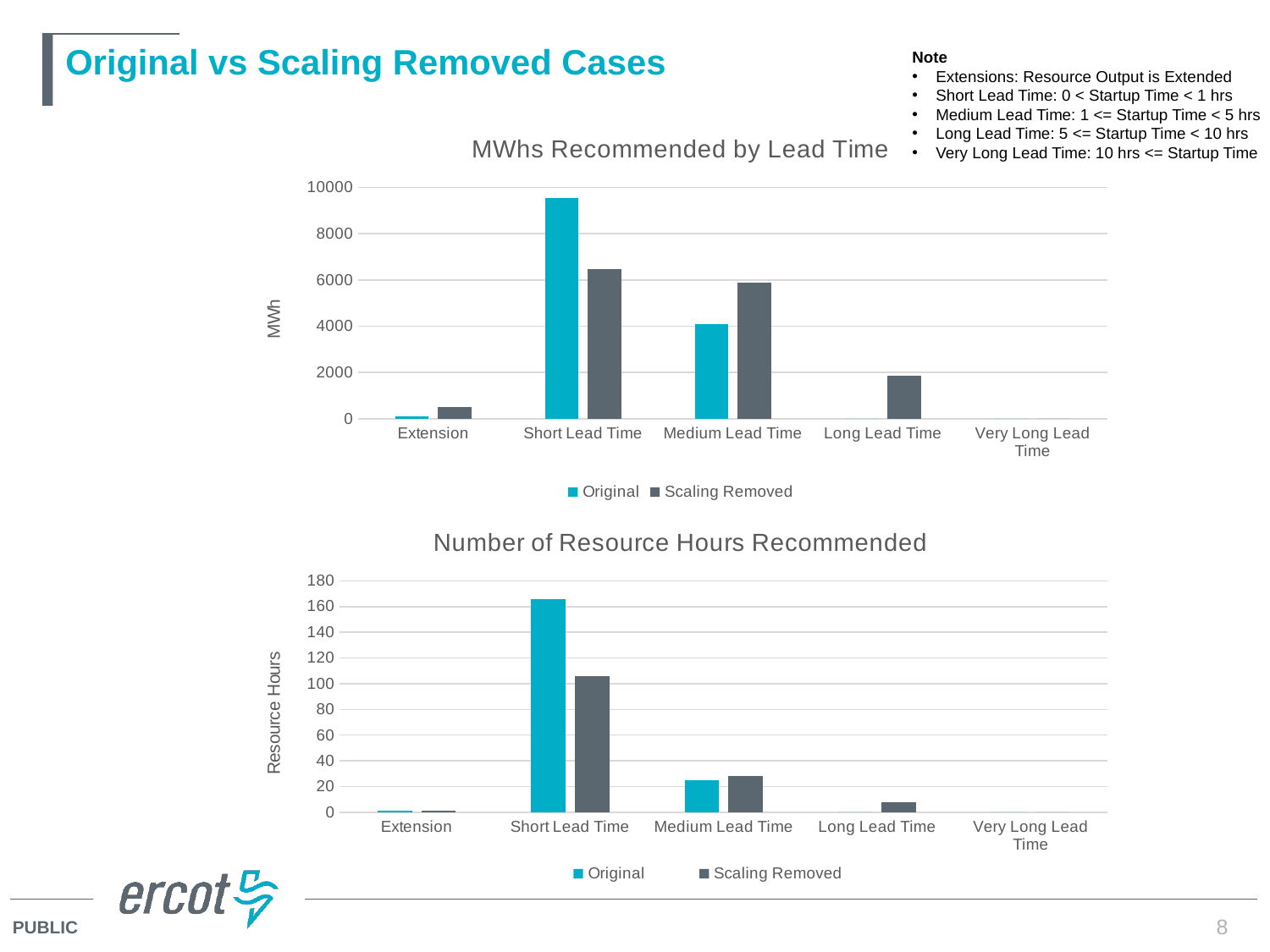
In the 'MWhs Recommended by Lead Time' chart, for Short Lead Time, which series has the larger value: Original or Scaling Removed? Original In the 'Number of Resource Hours Recommended' chart, which category has the highest Scaling Removed value? Short Lead Time In the 'MWhs Recommended by Lead Time' chart, which category has the highest Original value? Short Lead Time In the 'MWhs Recommended by Lead Time' chart, is the Scaling Removed value for Medium Lead Time greater or less than 4000? greater How many series does the legend of the 'Number of Resource Hours Recommended' chart list? 2 In the 'MWhs Recommended by Lead Time' chart, is the Original value for Short Lead Time greater or less than 8000? greater How many lead time categories are shown on the x axis of the 'MWhs Recommended by Lead Time' chart? 5 In the 'MWhs Recommended by Lead Time' chart, for Medium Lead Time, which series has the larger value: Original or Scaling Removed? Scaling Removed In the 'Number of Resource Hours Recommended' chart, for Short Lead Time, which series has the larger value: Original or Scaling Removed? Original What is the y-axis label of the 'Number of Resource Hours Recommended' chart? Resource Hours In the 'Number of Resource Hours Recommended' chart, is the Original value for Short Lead Time greater or less than 140? greater What kind of chart is the 'MWhs Recommended by Lead Time' chart? bar chart